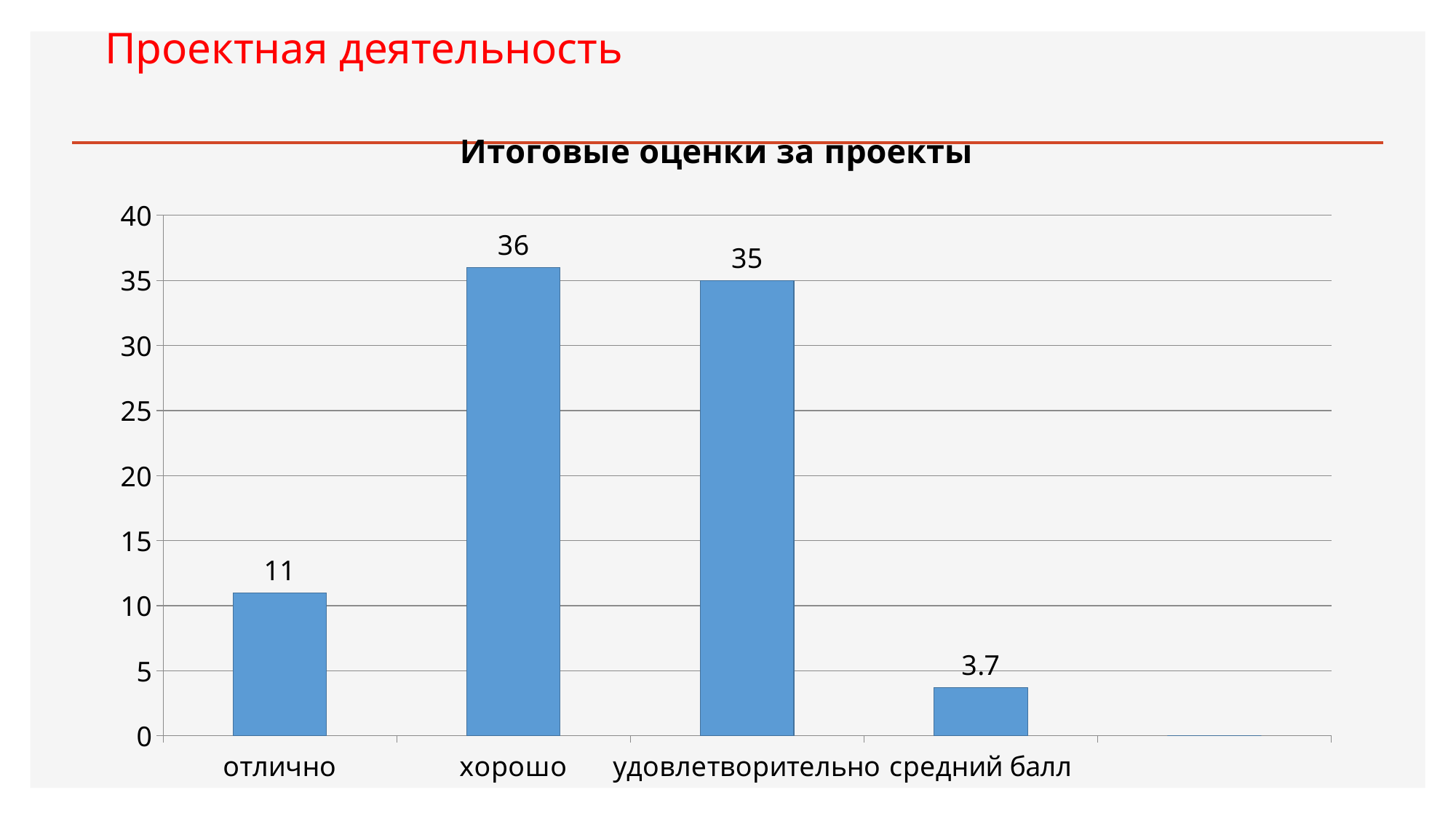
What is the title of the chart? Итоговые оценки за проекты What is the difference between the values for удовлетворительно and отлично? 24 Which of the labeled categories has the lowest value in the chart? средний балл What is the value for отлично in the chart? 11 Is the value for отлично greater or less than 15? less What kind of chart is shown on the slide? bar chart What is the value for средний балл in the chart? 3.7 What is the value for хорошо in the chart? 36 Which is larger, the value for отлично or the value for удовлетворительно? удовлетворительно Which category has the highest value in the chart? хорошо What is the difference between the values for хорошо and удовлетворительно? 1 What is the value for удовлетворительно in the chart? 35